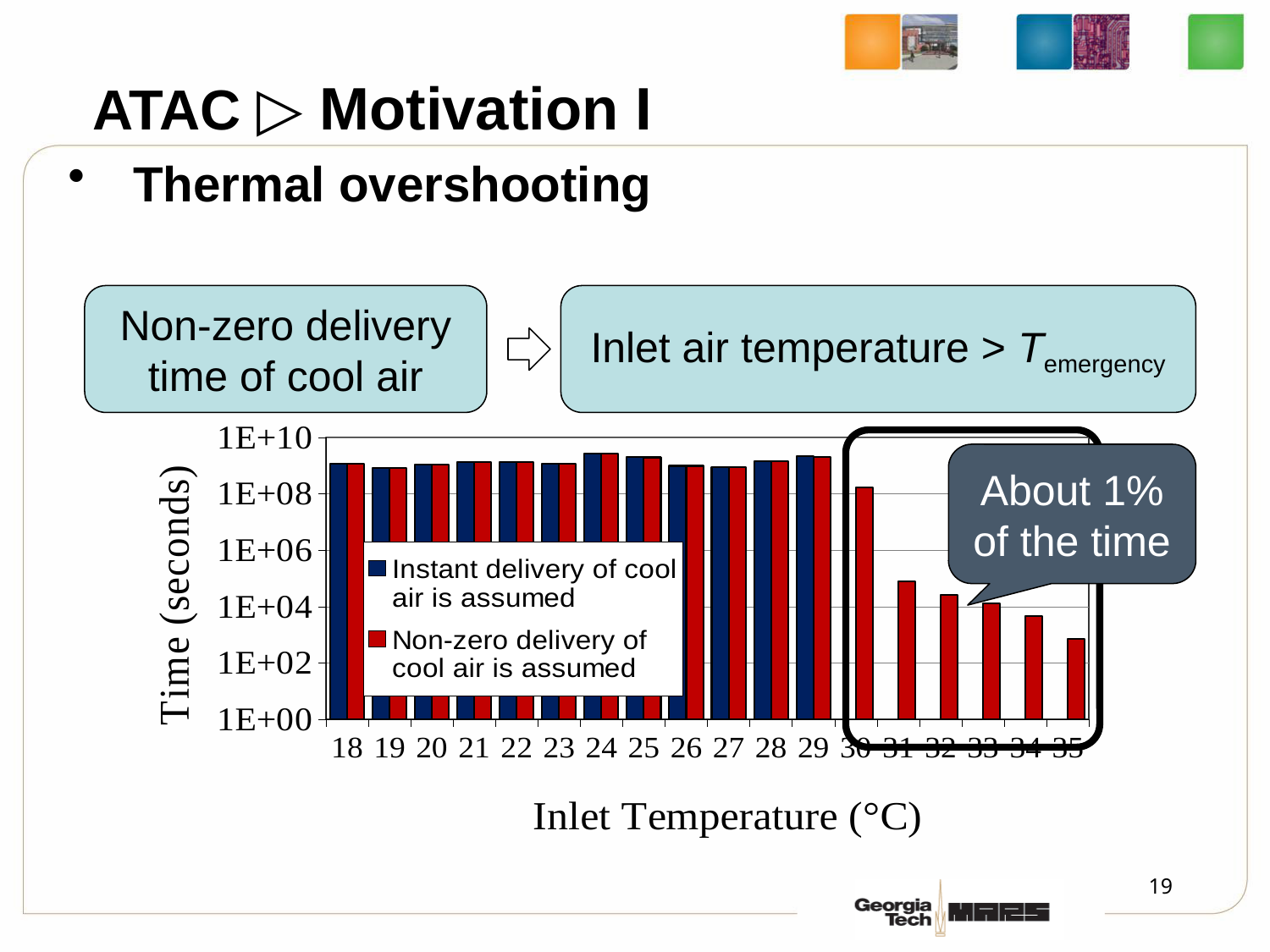
Do the values for 'Non-zero delivery of cool air is assumed' rise or fall from 30°C to 35°C? fall Is the value for 'Non-zero delivery of cool air is assumed' at 31°C greater or less than 1E+04? greater What is the title of the x axis? Inlet Temperature (°C) What is the title of the y axis? Time (seconds) Is the value for 'Non-zero delivery of cool air is assumed' at 18°C greater or less than 1E+08? greater For 'Non-zero delivery of cool air is assumed', is the value at 18°C or at 35°C larger? 18°C Which inlet temperature has the lowest value for 'Non-zero delivery of cool air is assumed'? 35 What kind of chart is shown on the slide? bar chart Is the value for 'Non-zero delivery of cool air is assumed' at 35°C greater or less than 1E+04? less How many series does the chart legend list? 2 How many inlet temperature categories are shown on the x axis? 18